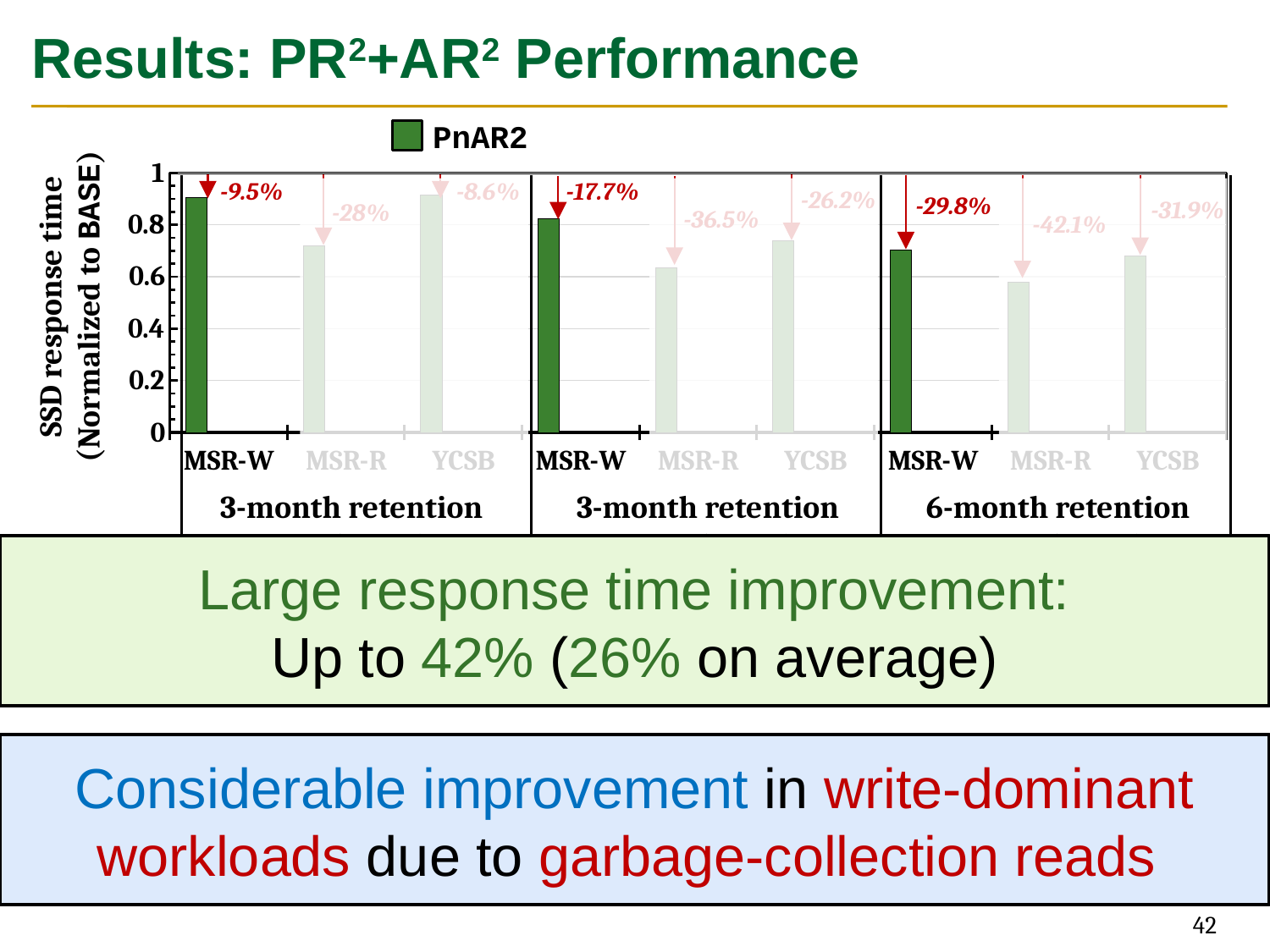
How many series does the chart legend list? 1 What percentage change is labeled above the YCSB bar in the middle panel? -26.2% Is the value for MSR-R in the left panel (3-month retention) greater or less than 0.8? less What is the name of the series shown in the legend? PnAR2 What percentage change is labeled above the MSR-W bar in the left panel (3-month retention)? -9.5% Which bar has the smallest labeled percentage reduction in the chart? YCSB in the left 3-month retention panel (-8.6%) What kind of chart is shown on the slide? bar chart In the left panel (3-month retention), which bar is taller, MSR-W or MSR-R? MSR-W Which bar has the largest labeled percentage reduction in the chart? MSR-R in the 6-month retention panel (-42.1%) What is the y-axis label of the chart? SSD response time (Normalized to BASE) How many bars are plotted in the chart in total across all three panels? 9 What percentage change is labeled above the MSR-R bar in the right panel (6-month retention)? -42.1%